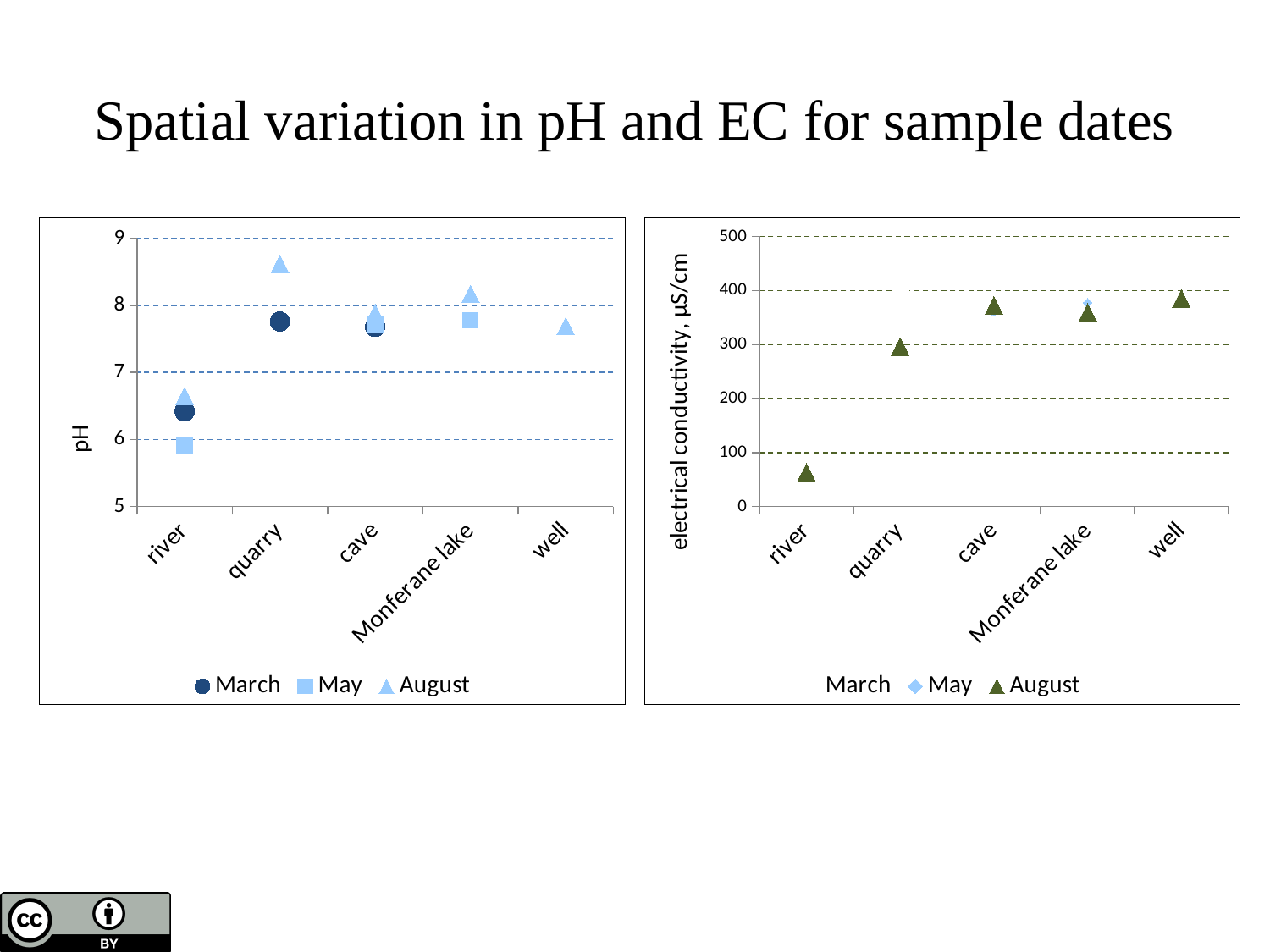
In the electrical conductivity chart on the right, how many series does the legend list? 3 In the pH chart on the left, which is larger: the August value for quarry or the August value for well? quarry In the pH chart on the left, at which site is the August pH value highest? quarry In the pH chart on the left, is the August value for quarry greater or less than 8? greater In the pH chart on the left, at which site is the lowest pH value plotted? river In the pH chart on the left, is the March value for river greater or less than 7? less What kind of chart is the pH chart on the left? scatter chart In the electrical conductivity chart on the right, at which site is the lowest value plotted? river In the electrical conductivity chart on the right, is the August value for river greater or less than 100? less In the pH chart on the left, how many sample sites are shown on the x axis? 5 In the electrical conductivity chart on the right, which is larger: the August value for cave or the August value for quarry? cave